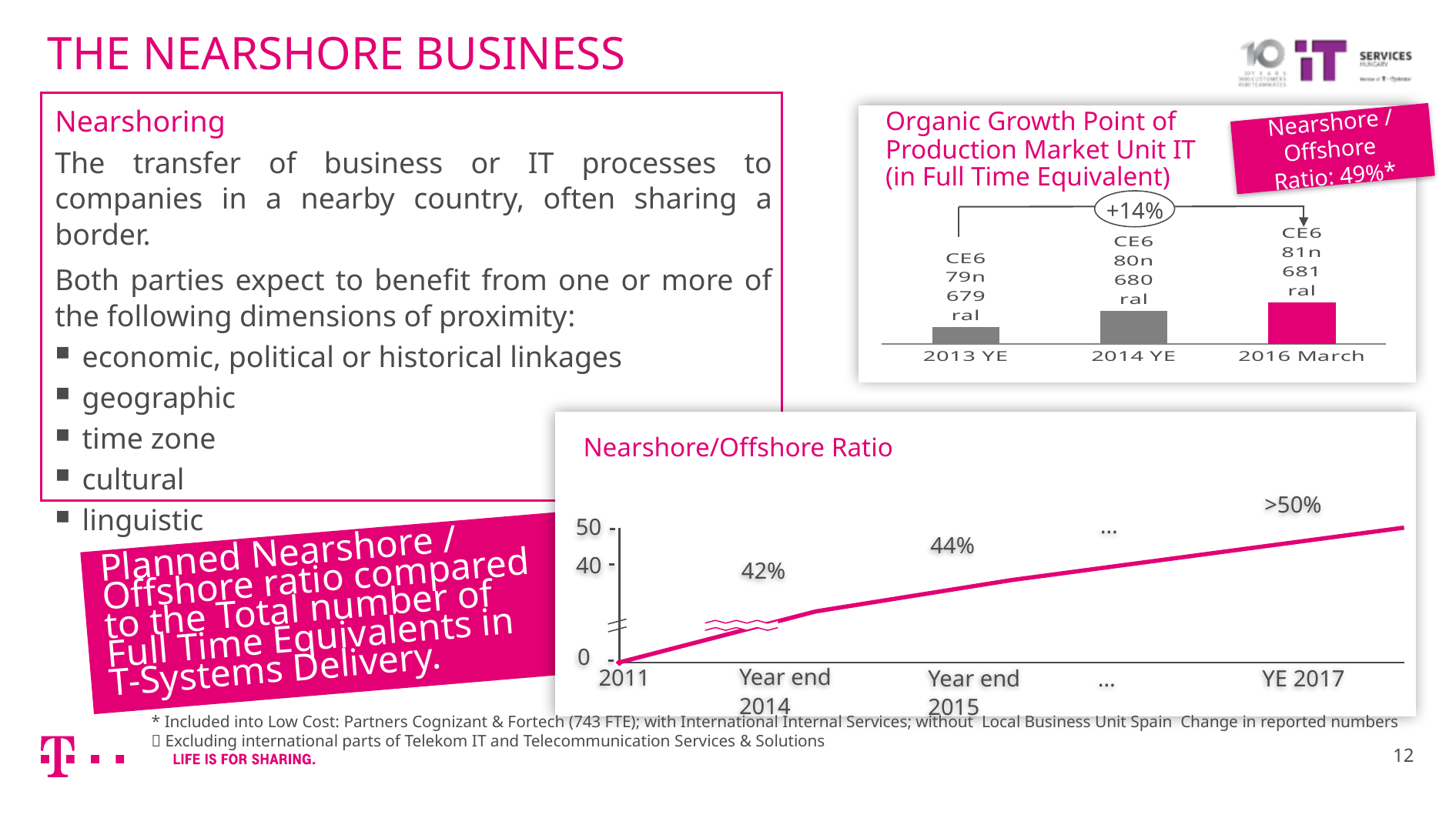
In the Nearshore/Offshore Ratio chart, what value is shown for YE 2017? >50% What kind of chart is the Nearshore/Offshore Ratio chart? line chart In the Nearshore/Offshore Ratio chart, what is the value at Year end 2014? 42% What kind of chart is the Organic Growth Point of Production Market Unit IT chart? bar chart In the Nearshore/Offshore Ratio chart, what is the value at Year end 2015? 44% In the Organic Growth Point of Production Market Unit IT chart, which category has the tallest bar? 2016 March In the Nearshore/Offshore Ratio chart, does the line rise or fall from 2011 to YE 2017? rises In the Nearshore/Offshore Ratio chart, what is the difference between the Year end 2015 and Year end 2014 values? 2% How many bars are in the Organic Growth Point of Production Market Unit IT chart? 3 In the Organic Growth Point of Production Market Unit IT chart, what growth percentage is shown in the annotation between 2013 YE and 2016 March? +14% In the Nearshore/Offshore Ratio chart, is the value for 2011 greater or less than 40? less In the Nearshore/Offshore Ratio chart, which is larger, the value at Year end 2014 or at Year end 2015? Year end 2015